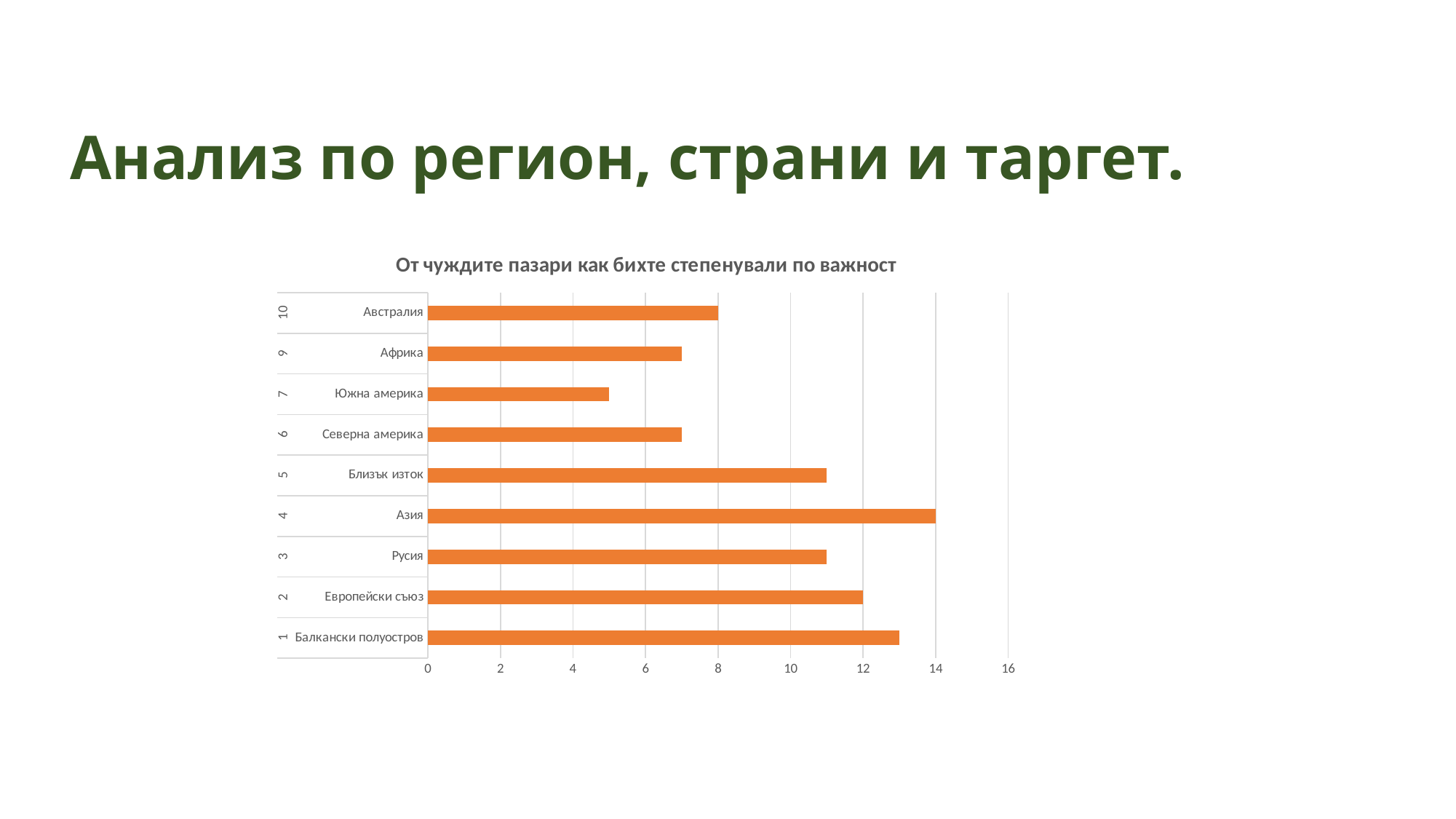
Which category has the highest value? Азия Is the value for Африка greater or less than 8? less Is the value for Балкански полуостров greater or less than 12? greater What is the value for Австралия? 8 Which category has the lowest value? Южна америка What is the value for Европейски съюз? 12 What is the difference between the values for Азия and Европейски съюз? 2 What is the value for Азия? 14 Which is larger, the value for Близък изток or the value for Южна америка? Близък изток What type of chart is shown on the slide? Bar chart How many categories are plotted in the chart? 9 What is the title of the chart? От чуждите пазари как бихте степенували по важност